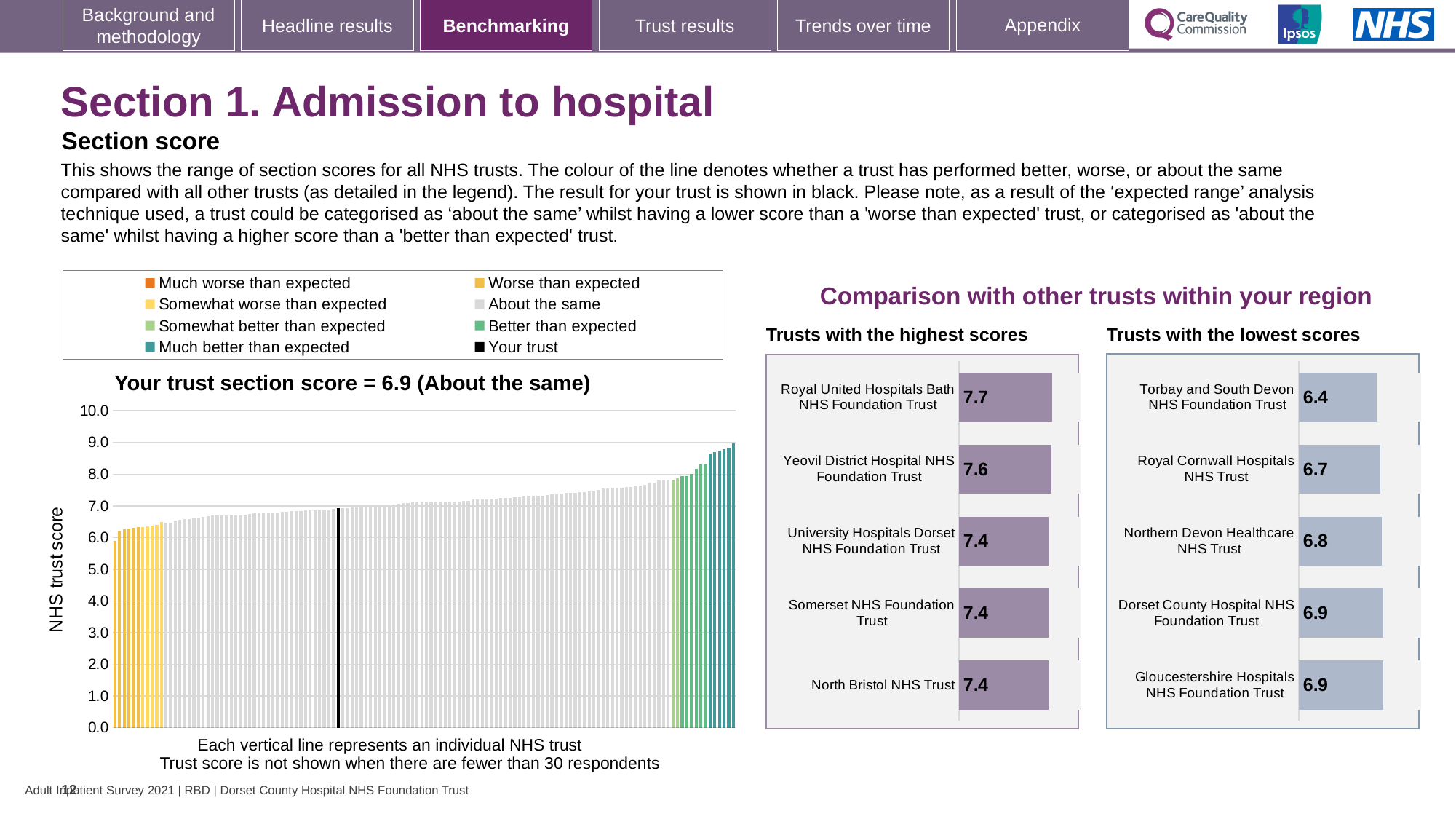
In the 'Trusts with the highest scores' chart, what is the score for Royal United Hospitals Bath NHS Foundation Trust? 7.7 What kind of chart is the 'Your trust section score' chart on the left? Bar chart What is the label on the vertical axis of the 'Your trust section score' chart? NHS trust score In the 'Trusts with the highest scores' chart, which trust has the highest score? Royal United Hospitals Bath NHS Foundation Trust How many trusts are shown in the 'Trusts with the highest scores' chart? 5 In the 'Trusts with the highest scores' chart, what is the difference between the scores of Royal United Hospitals Bath NHS Foundation Trust and Yeovil District Hospital NHS Foundation Trust? 0.1 How many entries does the legend above the 'Your trust section score' chart list? 8 In the 'Trusts with the lowest scores' chart, which trust has the lowest score? Torbay and South Devon NHS Foundation Trust In the 'Trusts with the lowest scores' chart, what is the score for Torbay and South Devon NHS Foundation Trust? 6.4 In the 'Trusts with the lowest scores' chart, which has the higher score: Royal Cornwall Hospitals NHS Trust or Northern Devon Healthcare NHS Trust? Northern Devon Healthcare NHS Trust In the 'Your trust section score' chart on the left, what is the section score for your trust? 6.9 In the 'Trusts with the lowest scores' chart, what is the difference between the scores of Royal Cornwall Hospitals NHS Trust and Torbay and South Devon NHS Foundation Trust? 0.3